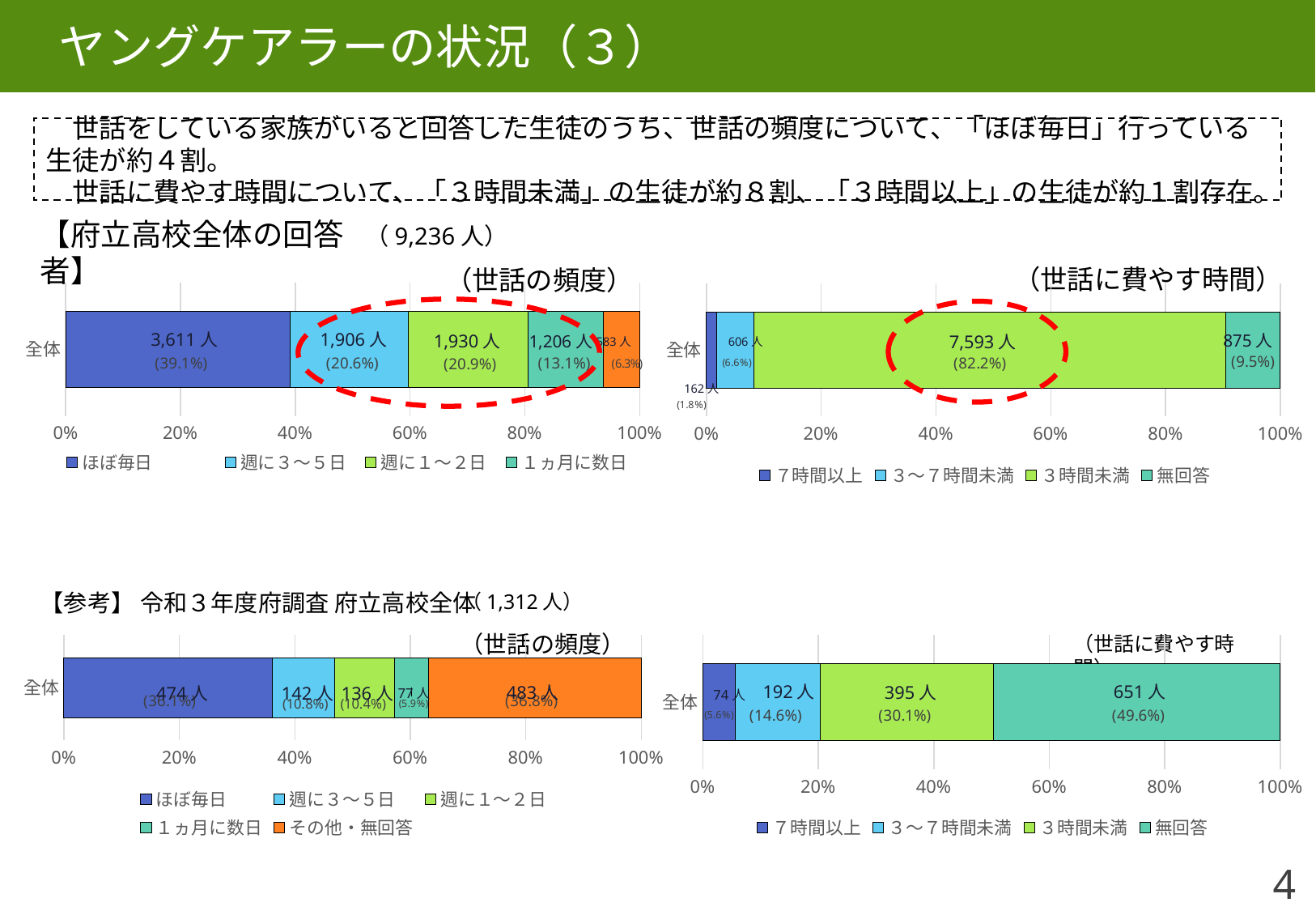
上段右の「世話に費やす時間」のグラフで、「３時間未満」の人数はいくつですか？ 7,593 人 上段左の「世話の頻度」のグラフで、「週に３〜５日」と「週に１〜２日」ではどちらの人数が多いですか？ 週に１〜２日 下段左の【参考】「世話の頻度」のグラフの凡例には、いくつの系列がありますか？ 5 上段右の「世話に費やす時間」のグラフで、「無回答」と「３〜７時間未満」の人数の差はいくつですか？ 269 人 下段右の【参考】「世話に費やす時間」のグラフで、「３時間未満」と「３〜７時間未満」の人数の差はいくつですか？ 203 人 下段左の【参考】「世話の頻度」のグラフで、最も人数が少ない区分はどれですか？ １ヵ月に数日 上段左の「世話の頻度」のグラフで、「週に３〜５日」の割合は何％ですか？ 20.6% 下段右の【参考】「世話に費やす時間」のグラフで、「無回答」の割合は何％ですか？ 49.6% 上段左の「世話の頻度」のグラフで、「ほぼ毎日」の人数はいくつですか？ 3,611 人 下段左の【参考】「世話の頻度」のグラフで、「その他・無回答」の人数はいくつですか？ 483 人 上段右の「世話に費やす時間」のグラフの凡例には、いくつの系列がありますか？ 4 上段右の「世話に費やす時間」のグラフで、最も人数が少ない区分はどれですか？ ７時間以上